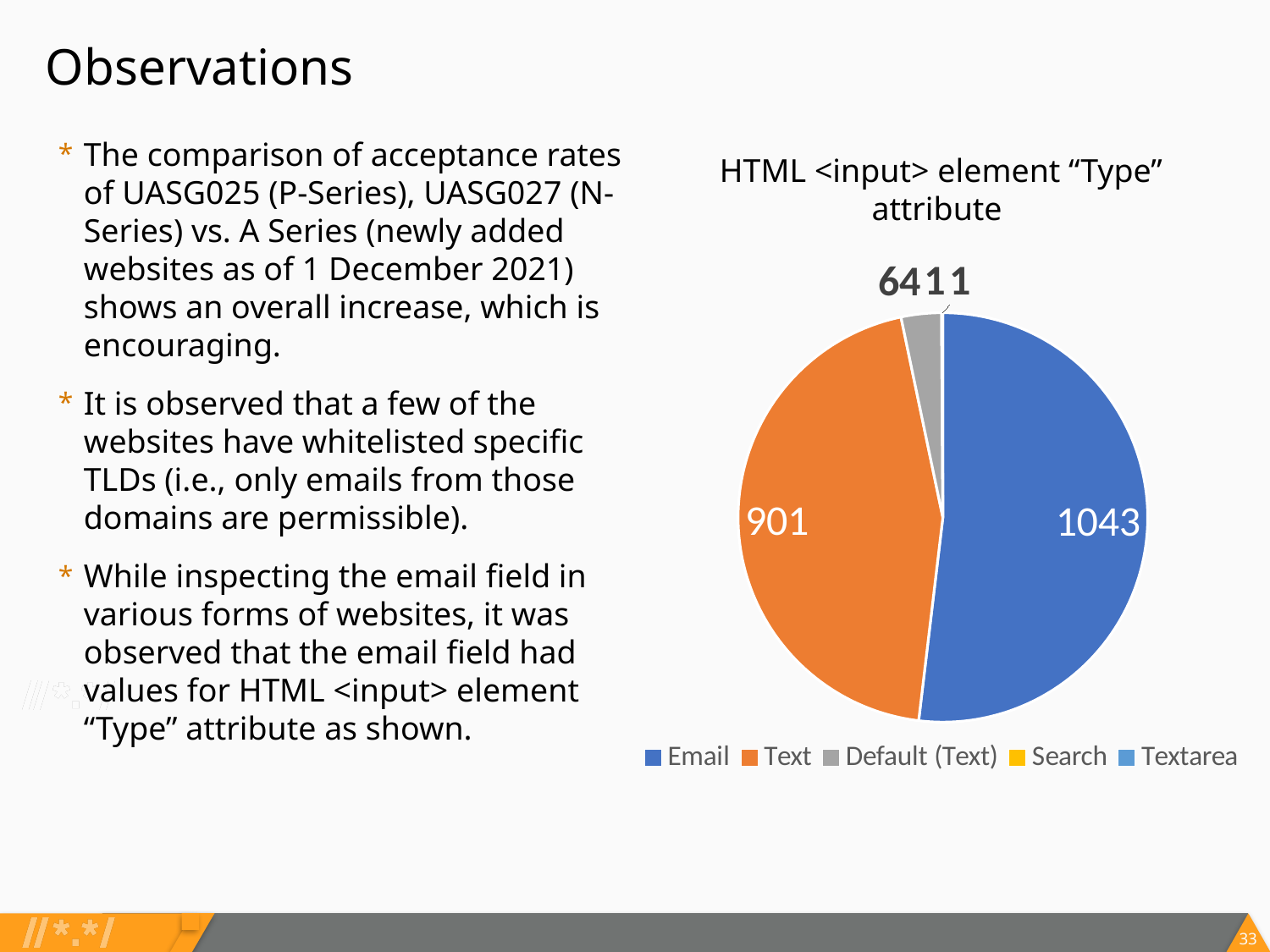
Which category is shown in orange in the pie chart? Text What type of chart is shown on the slide? pie chart What is the value for Text in the pie chart? 901 How many categories does the legend of the pie chart list? 5 What is the difference between the Email and Text values? 142 Which is larger, the value for Email or the value for Text? Email What is the value for Email in the pie chart? 1043 Which category has the largest slice in the pie chart? Email Is the value for Text greater or less than 1000? less Is the value for Email greater or less than 1000? greater What is the title of the chart? HTML <input> element "Type" attribute